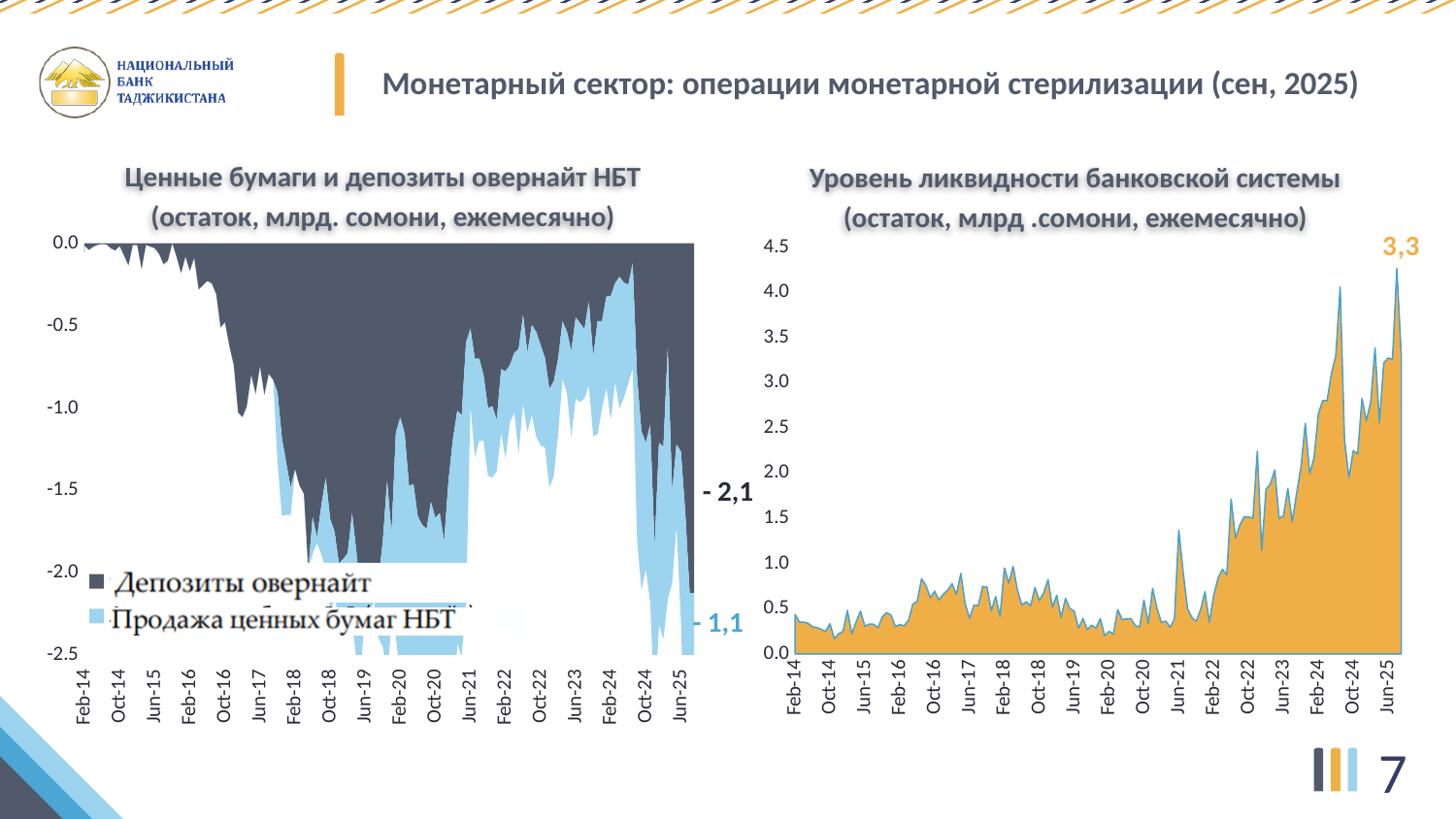
What kind of chart is 'Уровень ликвидности банковской системы'? Area chart In the chart 'Ценные бумаги и депозиты овернайт НБТ', what value is labeled in dark text at the right end of the chart? - 2,1 In the chart 'Уровень ликвидности банковской системы', is the value at Oct-16 greater or less than 1.0? less In the chart 'Уровень ликвидности банковской системы', do the values generally rise or fall from Feb-14 to Jun-25? Rise In the chart 'Уровень ликвидности банковской системы', is the value at Feb-14 greater or less than 0.5? less In the chart 'Уровень ликвидности банковской системы', what is the highest tick shown on the y axis? 4.5 In the chart 'Ценные бумаги и депозиты овернайт НБТ', what value is labeled in light blue at the right end of the chart? - 1,1 How many series does the legend of the chart 'Ценные бумаги и депозиты овернайт НБТ' list? 2 In the chart 'Уровень ликвидности банковской системы', is the value at Feb-24 greater or less than 2.0? greater In the chart 'Уровень ликвидности банковской системы', what value is labeled at the right end of the series? 3,3 In the chart 'Ценные бумаги и депозиты овернайт НБТ', which series is shown in dark grey according to the legend? Депозиты овернайт